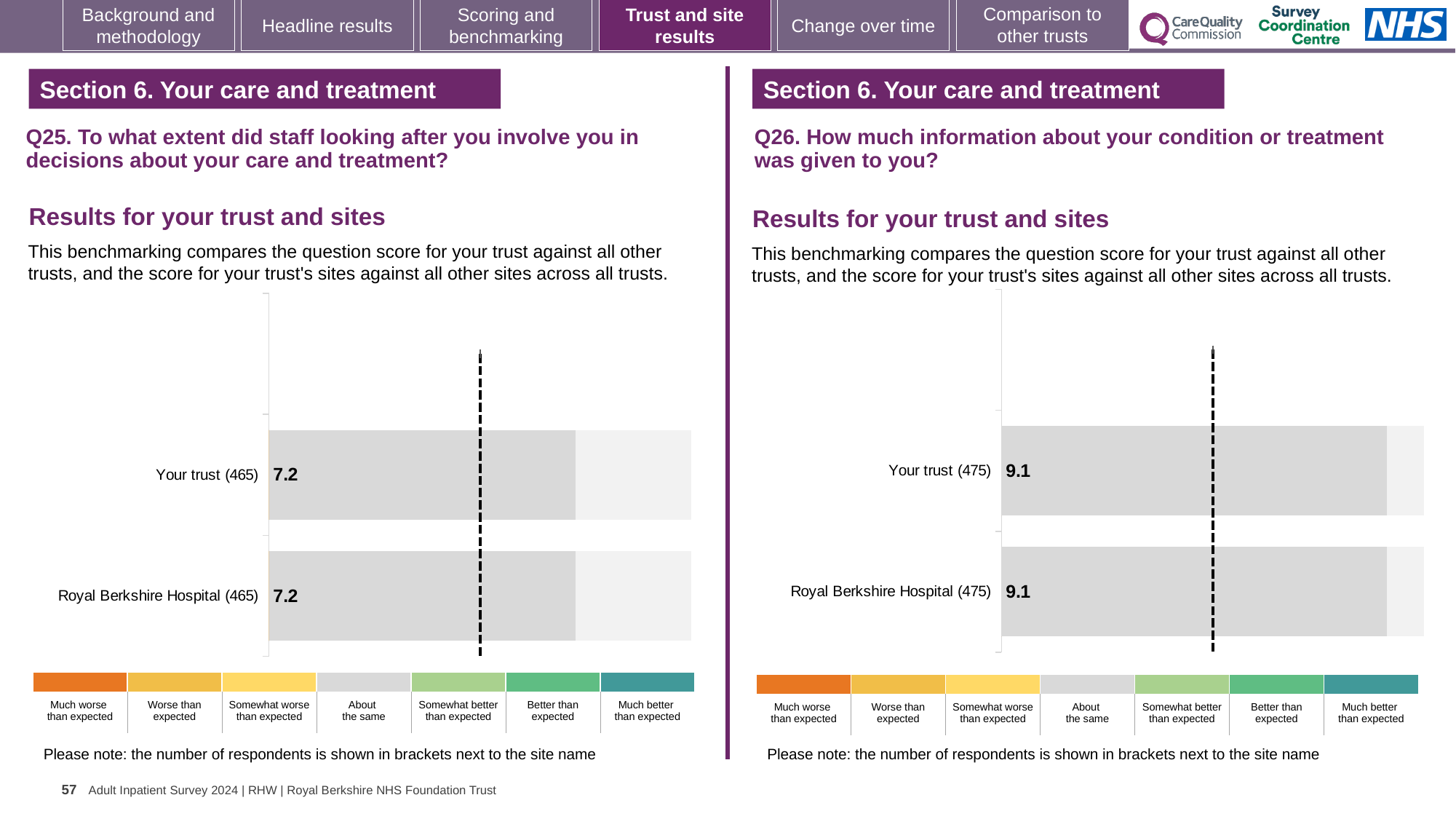
In the Q25 chart on the left, how many respondents are shown in brackets for Your trust? 465 Is the Your trust score in the Q25 chart on the left the same as the Royal Berkshire Hospital score in that chart? Yes How many bars are plotted in the Q25 chart on the left? 2 What kind of chart is used for the Q26 results on the right? Bar chart In the Q25 chart on the left, what is the score for Your trust? 7.2 How many rating categories are shown in the colour key beneath the Q25 chart on the left? 7 In the Q26 chart on the right, how many respondents are shown in brackets for Royal Berkshire Hospital? 475 What is the difference between the Your trust score in the Q26 chart and the Your trust score in the Q25 chart? 1.9 In the Q25 chart on the left, what is the score for Royal Berkshire Hospital? 7.2 In the Q26 chart on the right, what is the score for Your trust? 9.1 Which section heading appears above both charts on the slide? Section 6. Your care and treatment In the Q26 chart on the right, what is the score for Royal Berkshire Hospital? 9.1